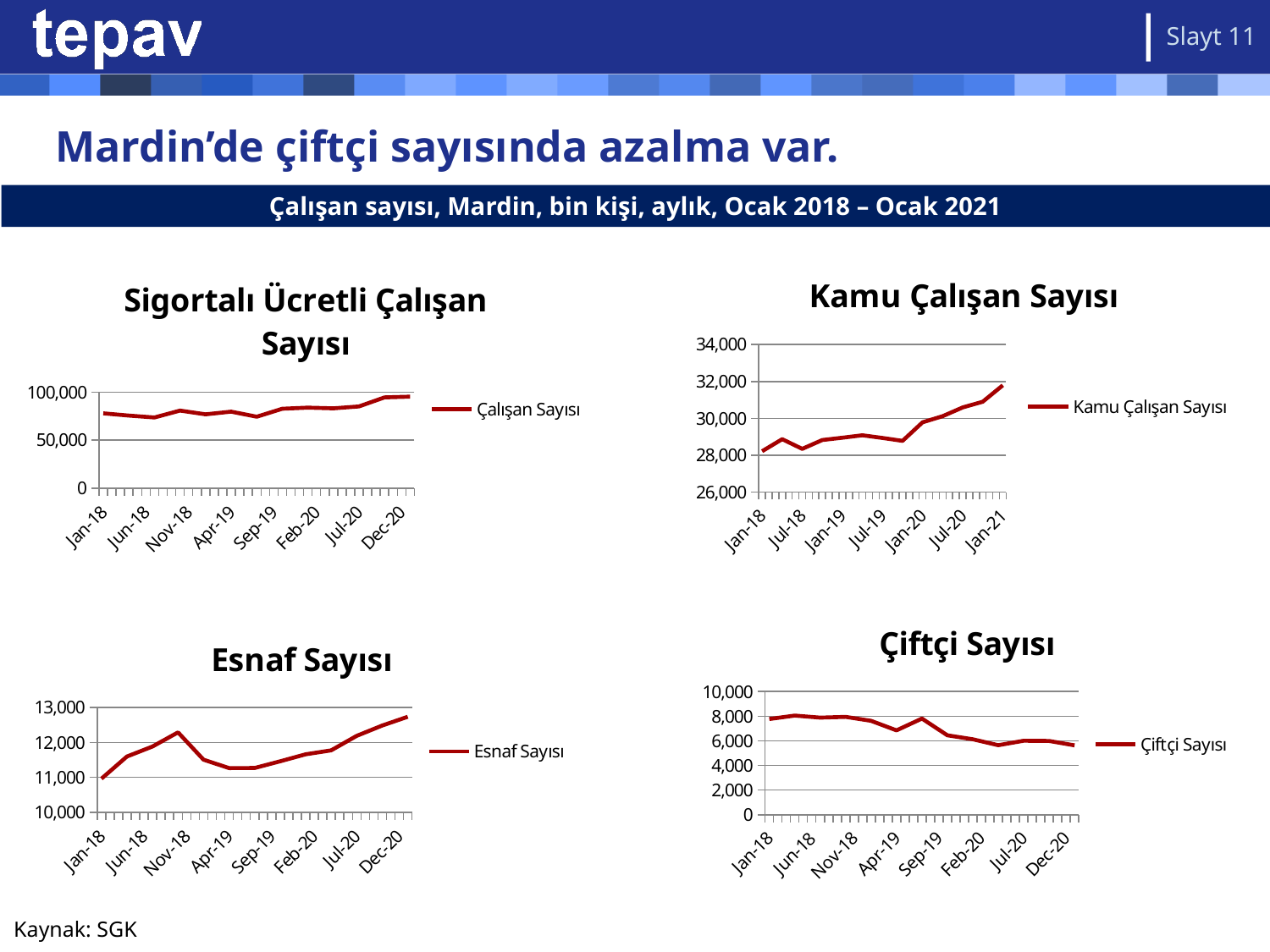
How many series does the legend of the "Kamu Çalışan Sayısı" chart list? 1 What is the legend entry shown in the "Esnaf Sayısı" chart? Esnaf Sayısı In the "Esnaf Sayısı" chart, is the value at Dec-20 greater or less than 12,000? greater In the "Kamu Çalışan Sayısı" chart, do the values rise or fall from Jan-18 to Jan-21? rise In the "Kamu Çalışan Sayısı" chart, is the value at Jan-21 greater or less than 30,000? greater In the "Çiftçi Sayısı" chart, is the value at Jan-18 greater or less than 6,000? greater In the "Çiftçi Sayısı" chart, do the values rise or fall from Jan-18 to Dec-20? fall What kind of chart is the "Sigortalı Ücretli Çalışan Sayısı" chart? line chart In the "Sigortalı Ücretli Çalışan Sayısı" chart, do the values overall rise or fall from Jan-18 to Dec-20? rise